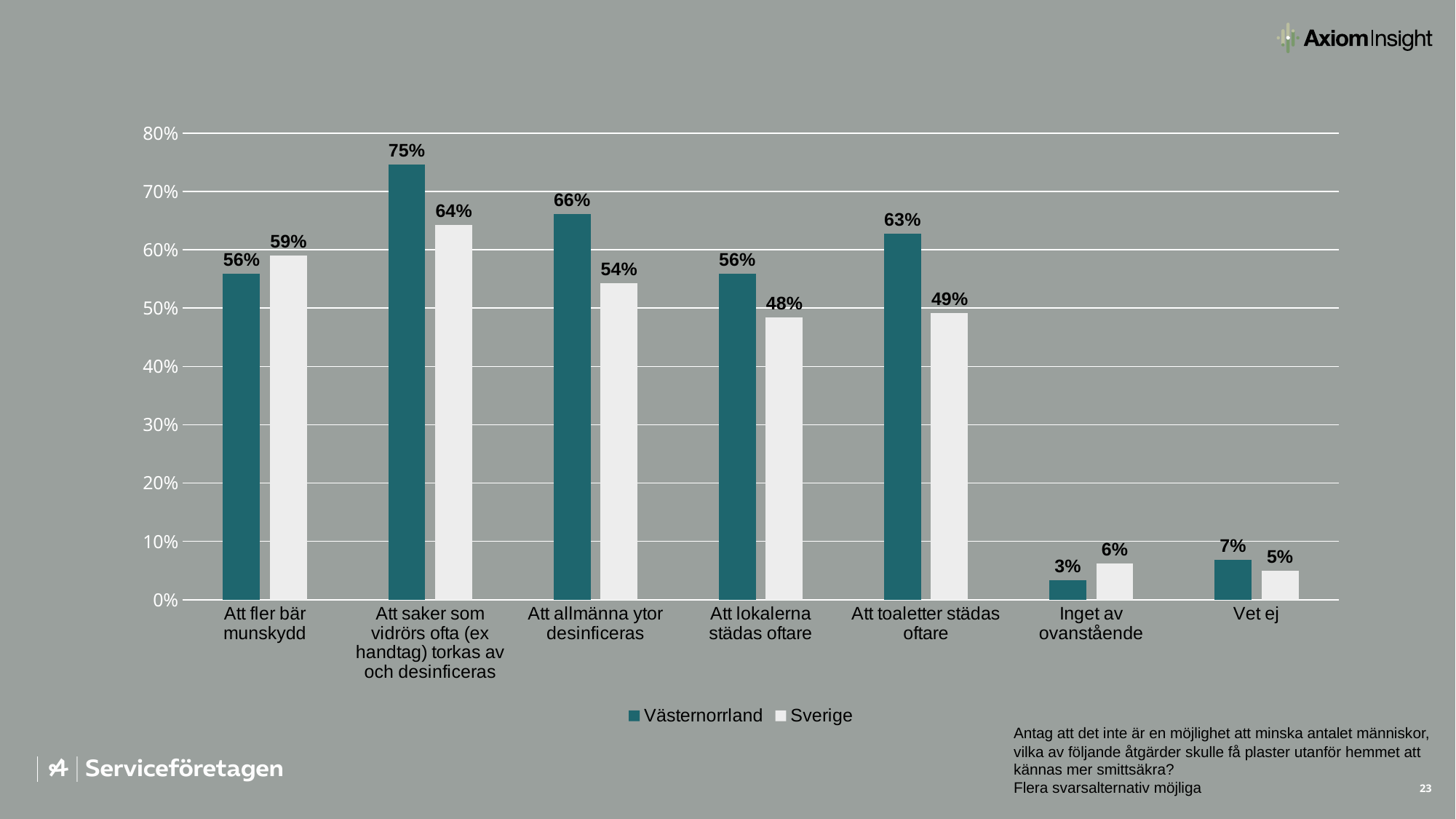
What are the two series listed in the legend? Västernorrland and Sverige What is the value for Västernorrland for "Att saker som vidrörs ofta (ex handtag) torkas av och desinficeras"? 75% Which is larger for "Att toaletter städas oftare": Västernorrland or Sverige? Västernorrland What is the value for Sverige for "Att fler bär munskydd"? 59% What kind of chart is shown on the slide? Bar chart What is the value for Sverige for "Att toaletter städas oftare"? 49% Which category has the lowest value for Västernorrland? Inget av ovanstående How many series does the legend list? 2 How many categories are shown on the x axis? 7 Which category has the highest value for Västernorrland? Att saker som vidrörs ofta (ex handtag) torkas av och desinficeras What is the difference between Västernorrland and Sverige for "Att allmänna ytor desinficeras"? 12% Which is larger for "Att fler bär munskydd": Västernorrland or Sverige? Sverige